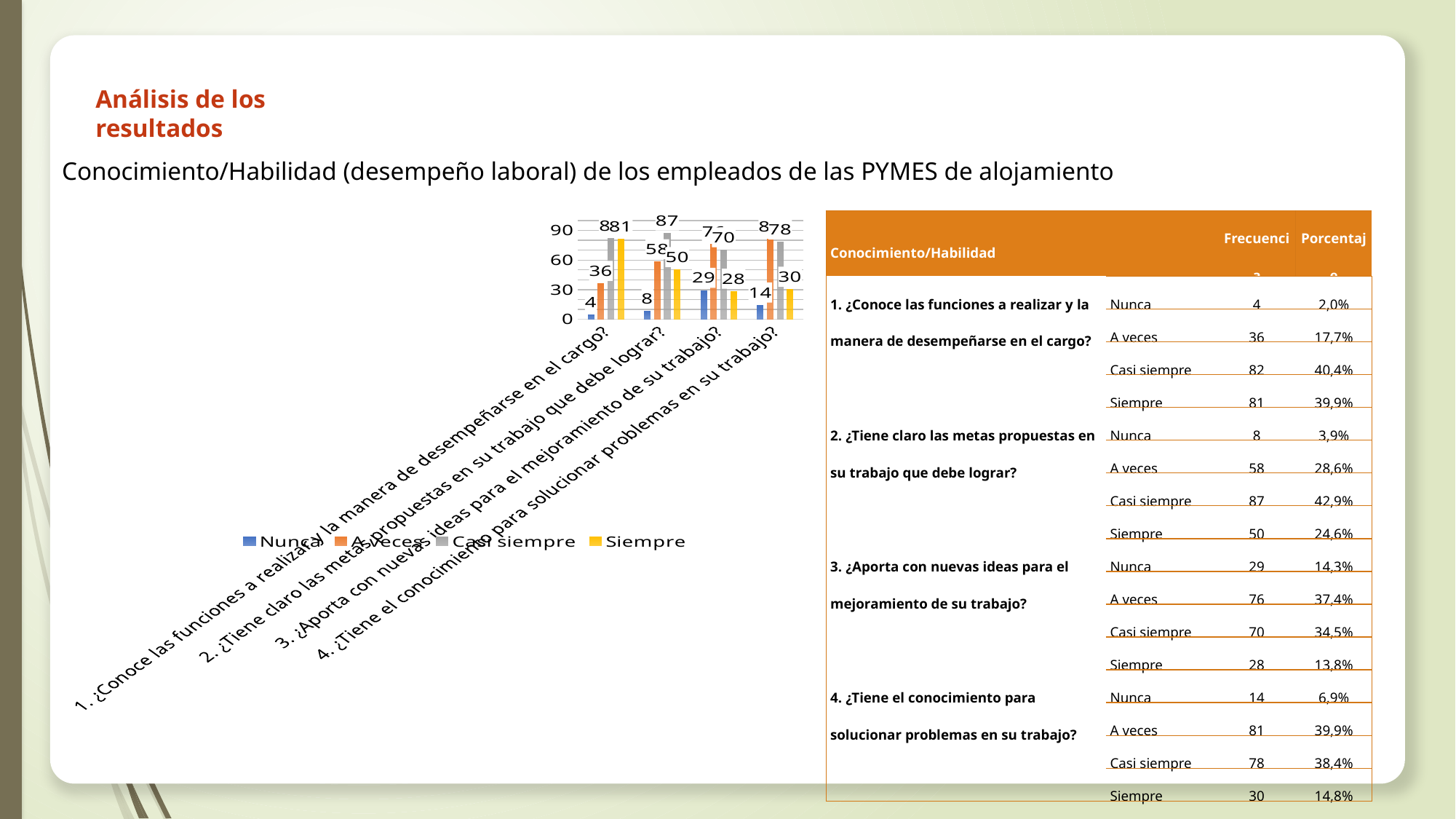
In the chart, what is the value of Casi siempre for question 2 (¿Tiene claro las metas propuestas en su trabajo que debe lograr?)? 87 How many series does the chart legend list? 4 In the chart, is the value of Siempre for question 2 greater or less than 30? greater In the chart, what is the difference between Casi siempre and A veces for question 2 (¿Tiene claro las metas propuestas en su trabajo que debe lograr?)? 29 How many question categories are plotted on the x axis of the chart? 4 In the chart, is the Nunca value larger for question 1 or for question 3? question 3 In the chart, what is the value of Siempre for question 4 (¿Tiene el conocimiento para solucionar problemas en su trabajo?)? 30 In the chart, what is the value of Nunca for question 1 (¿Conoce las funciones a realizar y la manera de desempeñarse en el cargo?)? 4 What kind of chart is shown on the slide? bar chart In the chart, what is the value of A veces for question 2 (¿Tiene claro las metas propuestas en su trabajo que debe lograr?)? 58 In the chart, which series has the lowest value for question 4 (¿Tiene el conocimiento para solucionar problemas en su trabajo?)? Nunca In the chart, which series has the highest value for question 2 (¿Tiene claro las metas propuestas en su trabajo que debe lograr?)? Casi siempre